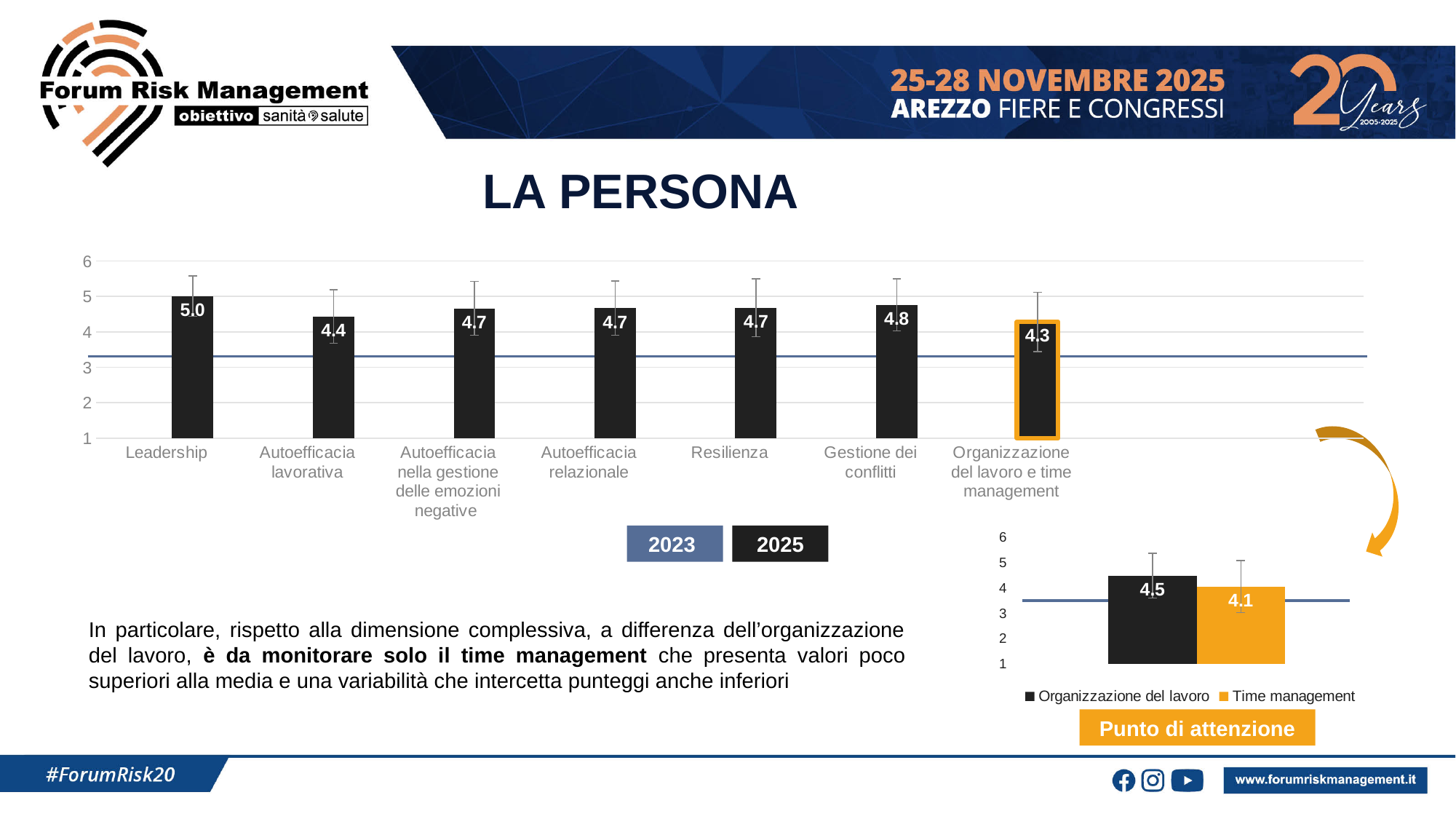
In the large bar chart, what is the value for Gestione dei conflitti? 4.8 What kind of chart is the large chart under the title LA PERSONA? Bar chart In the large bar chart, what is the value for Leadership? 5.0 In the small bar chart at the bottom right, how many series does the legend list? 2 In the large bar chart, what is the value for Autoefficacia lavorativa? 4.4 In the large bar chart, what is the difference between the values for Leadership and Autoefficacia lavorativa? 0.6 In the large bar chart, what is the value for Organizzazione del lavoro e time management? 4.3 In the large bar chart, how many categories are shown on the x axis? 7 In the large bar chart, which category has the highest value? Leadership In the small bar chart at the bottom right, what is the value for Time management? 4.1 In the small bar chart at the bottom right, which is larger: Organizzazione del lavoro or Time management? Organizzazione del lavoro In the large bar chart, which category has the lowest value? Organizzazione del lavoro e time management